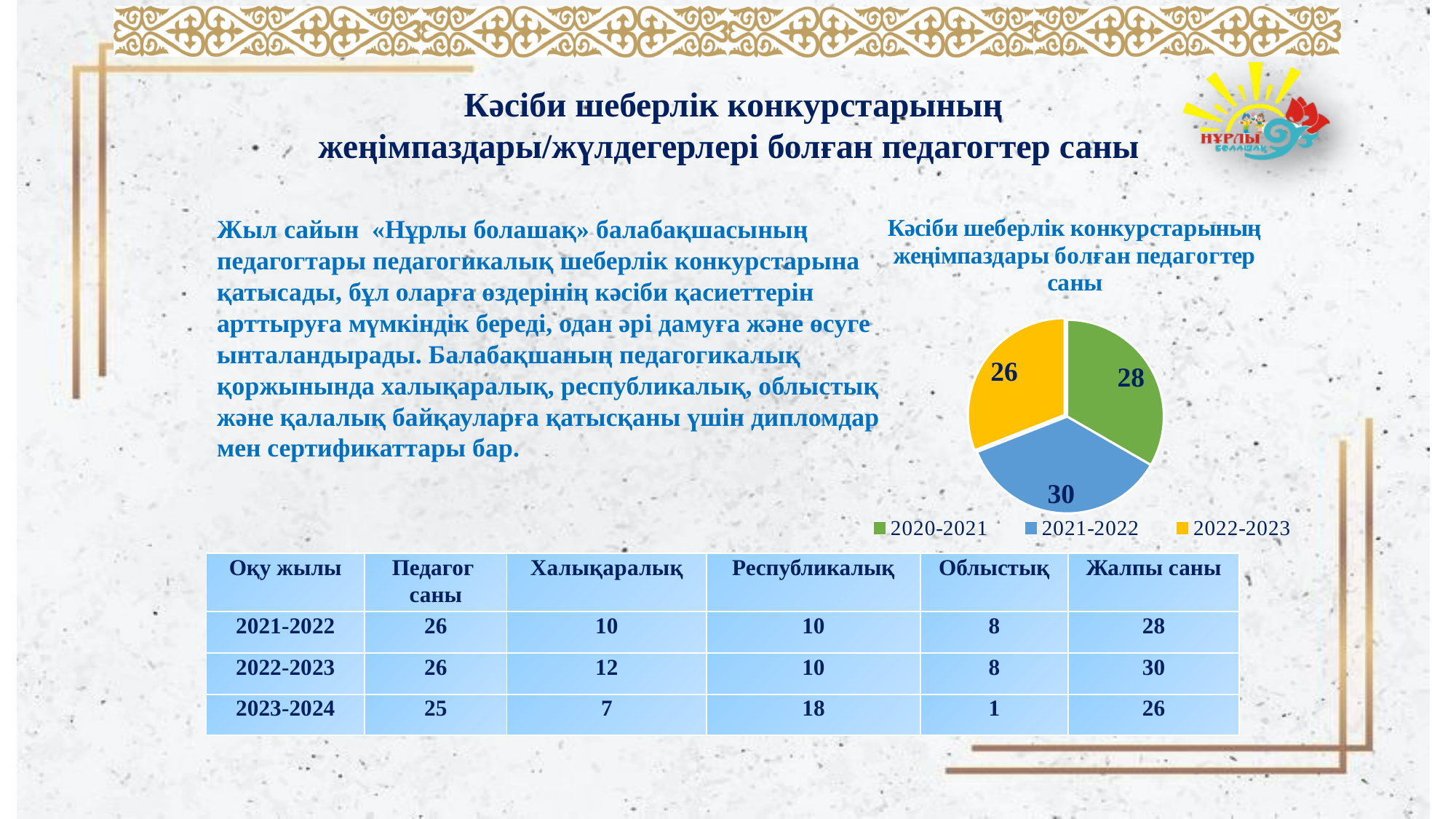
What is the value for 2021-2022 in the pie chart? 30 How many entries does the legend of the pie chart list? 3 What kind of chart is shown on the slide? Pie chart Which is larger in the pie chart, the value for 2020-2021 or the value for 2021-2022? 2021-2022 What is the value for 2022-2023 in the pie chart? 26 What is the value for 2020-2021 in the pie chart? 28 What colour is the slice for 2022-2023 in the pie chart? Yellow How many slices does the pie chart have? 3 Which year has the smallest slice in the pie chart? 2022-2023 What is the difference between the values for 2021-2022 and 2022-2023 in the pie chart? 4 What is the difference between the values for 2020-2021 and 2022-2023 in the pie chart? 2 Which year has the largest slice in the pie chart? 2021-2022